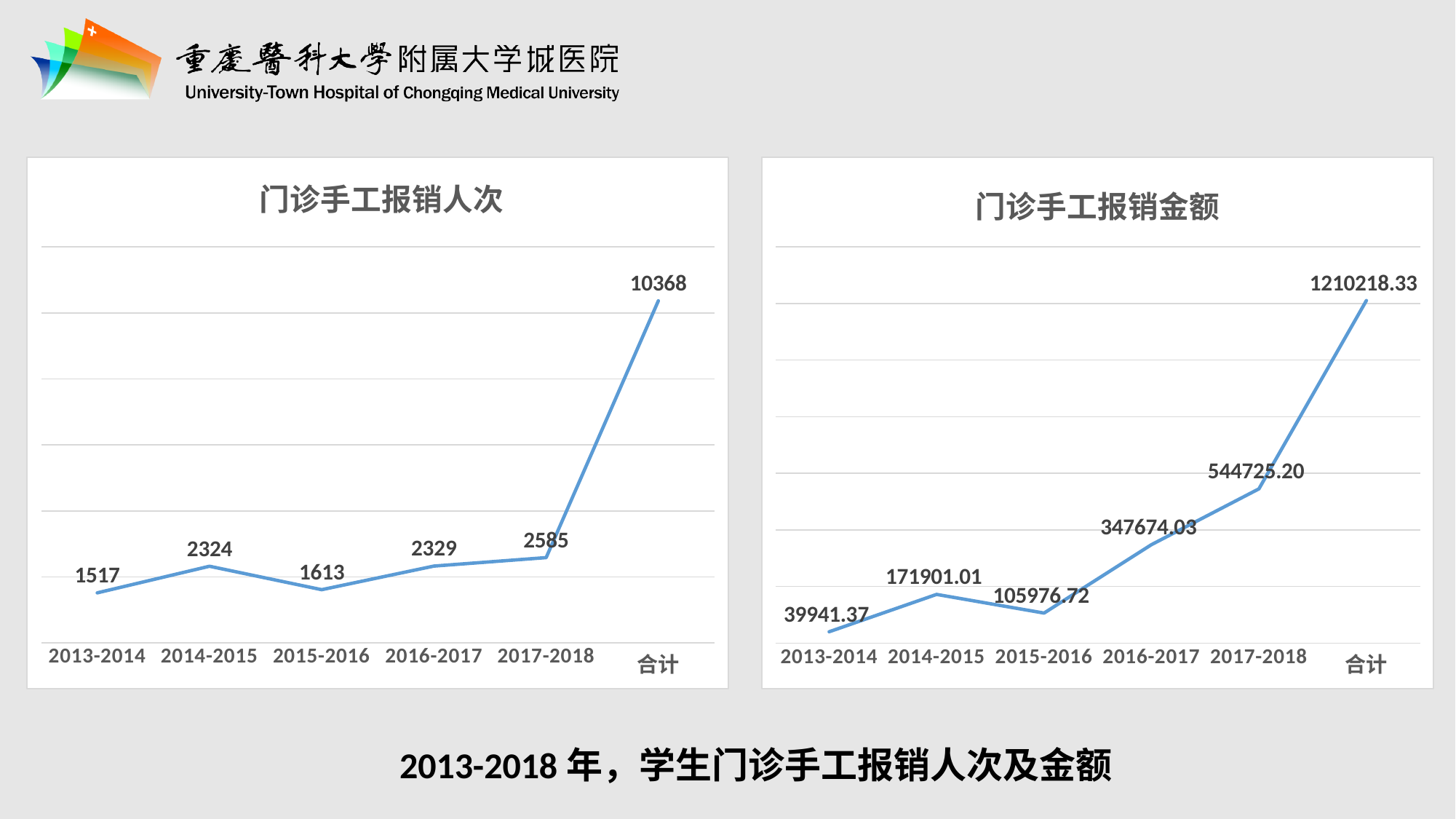
In the left chart titled 门诊手工报销人次, what is the value for 2013-2014? 1517 In the right chart titled 门诊手工报销金额, what is the value for 合计? 1210218.33 In the left chart titled 门诊手工报销人次, which year period among 2013-2014 to 2017-2018 has the lowest value? 2013-2014 In the left chart titled 门诊手工报销人次, what is the value for 合计? 10368 How many categories are shown on the x axis of the right chart titled 门诊手工报销金额? 6 In the left chart titled 门诊手工报销人次, what is the value for 2017-2018? 2585 In the right chart titled 门诊手工报销金额, which year period among 2013-2014 to 2017-2018 has the highest value? 2017-2018 In the left chart titled 门诊手工报销人次, which is larger, the value for 2014-2015 or the value for 2015-2016? 2014-2015 In the left chart titled 门诊手工报销人次, what is the difference between the values for 2017-2018 and 2013-2014? 1068 In the right chart titled 门诊手工报销金额, what is the value for 2016-2017? 347674.03 In the right chart titled 门诊手工报销金额, what is the difference between the values for 2017-2018 and 2016-2017? 197051.17 What kind of chart is the left chart titled 门诊手工报销人次? line chart